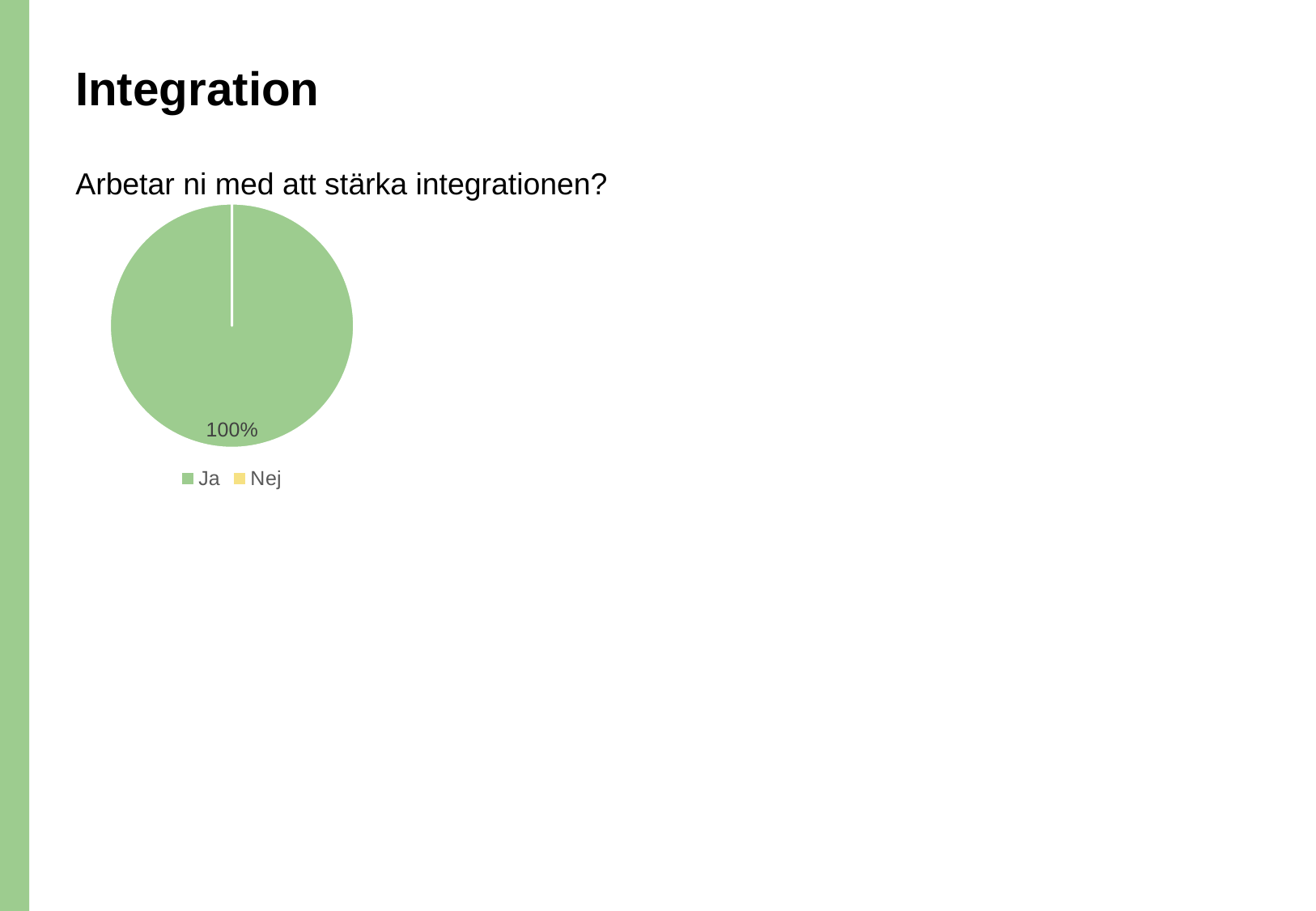
How many entries does the legend list? 2 Which is larger, the share for "Ja" or the share for "Nej"? Ja What share of the pie does "Ja" represent? 100% What kind of chart is shown on the slide? pie chart Which category has the largest share of the pie? Ja What question does the chart answer, as written above it? Arbetar ni med att stärka integrationen? What colour represents "Ja" in the legend? green Is the share for "Ja" greater or less than 50%? greater What is the value printed on the pie chart? 100%